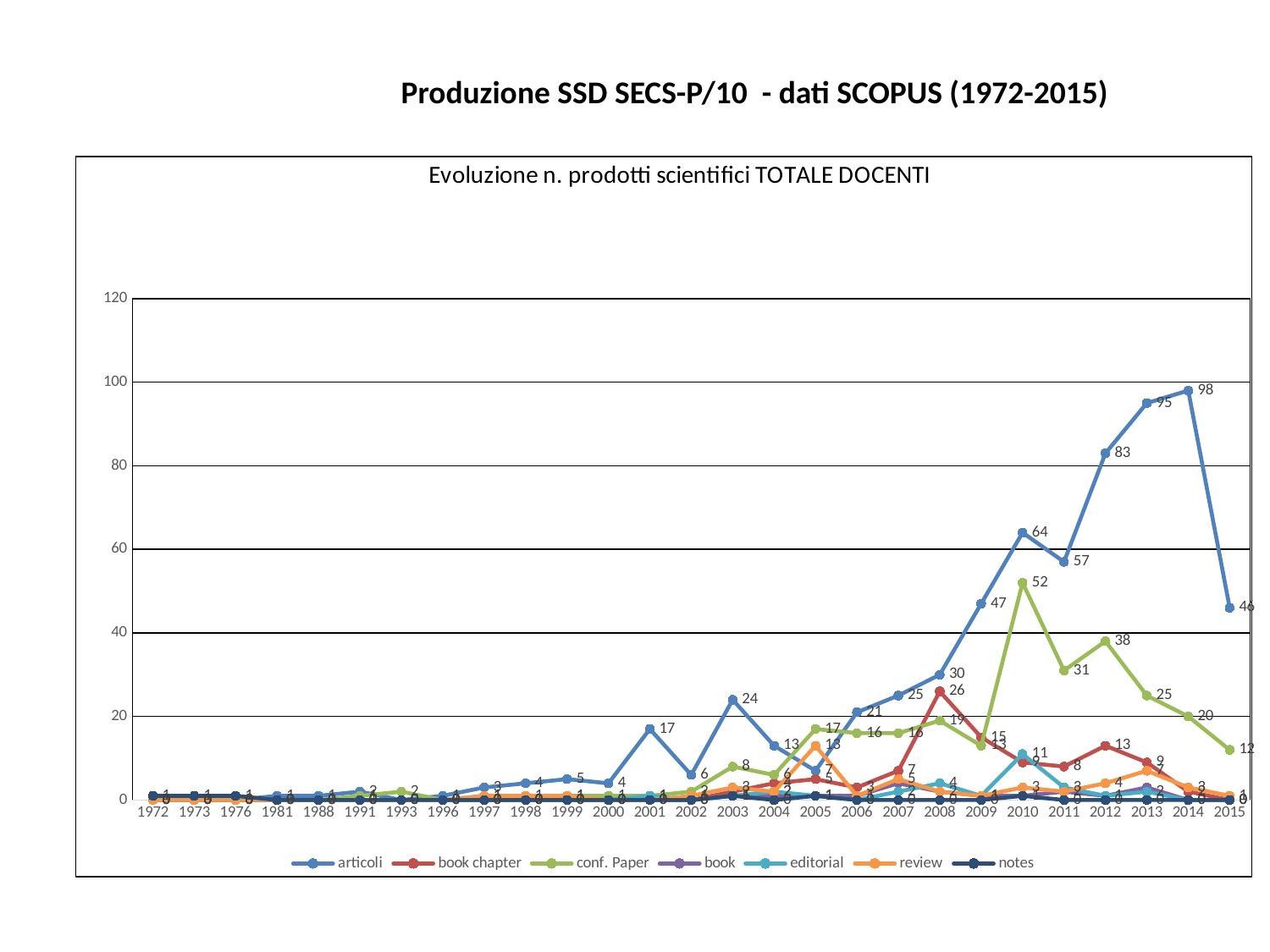
How many years are shown on the x axis? 27 How many series does the legend list? 7 What is the value of book chapter in 2008? 26 What is the value of articoli in 2013? 95 What is the title of the chart? Evoluzione n. prodotti scientifici TOTALE DOCENTI In which year does the articoli series reach its highest value? 2014 What is the difference between the articoli values in 2014 and 2015? 52 What is the difference between the conf. Paper values in 2010 and 2011? 21 What kind of chart is shown on the slide? line chart Is the value for articoli in 2010 greater or less than 60? greater What is the value of conf. Paper in 2010? 52 In 2012, which is larger: articoli or conf. Paper? articoli